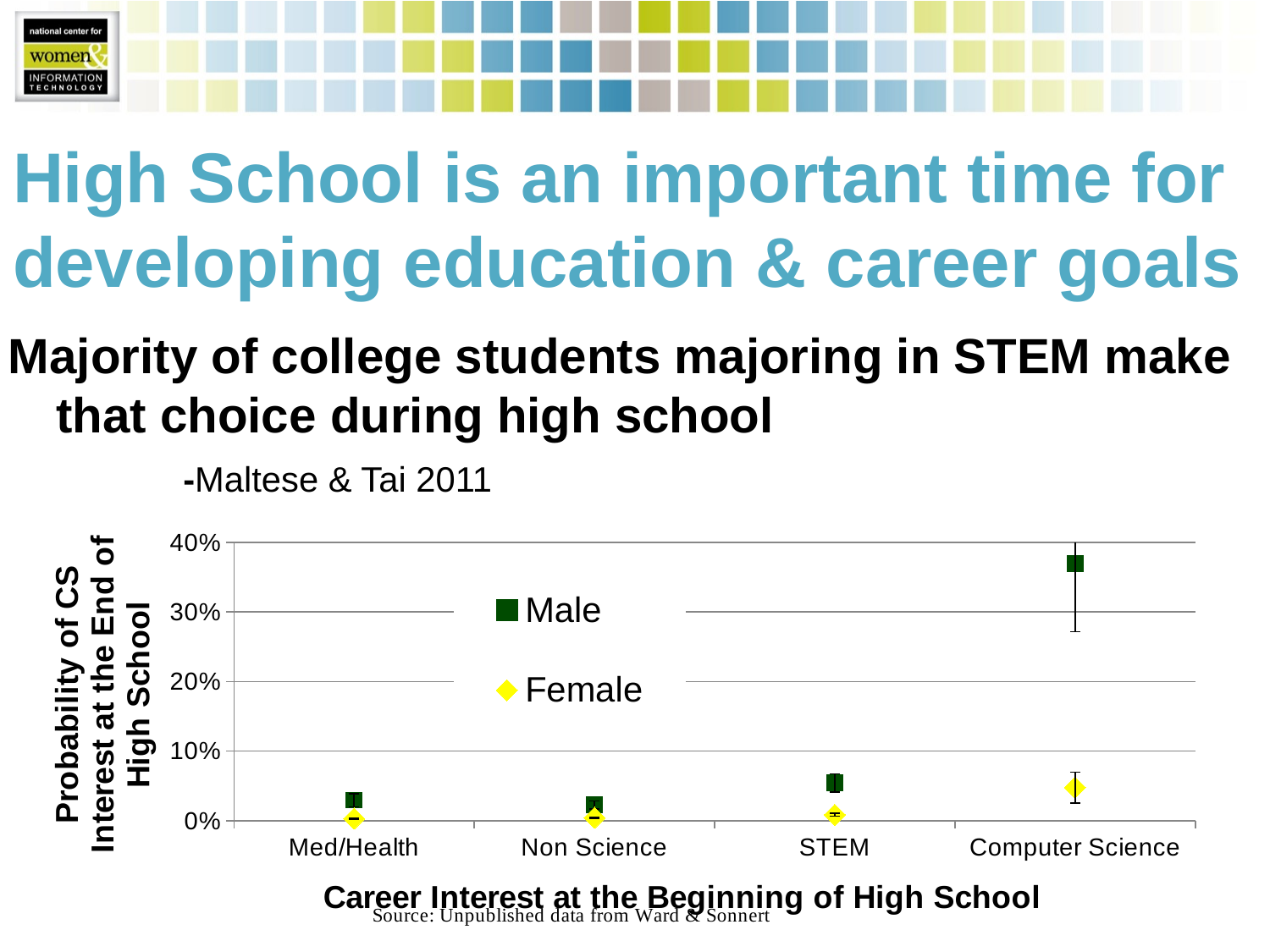
What marker shape and colour represents the Female series in the legend? Yellow diamond How many categories are shown on the x axis of the chart? 4 Is the Female value for Computer Science greater or less than 10%? less Is the Male value for STEM greater or less than 10%? less For the Male series, which is larger: the value for Computer Science or the value for STEM? Computer Science Which category has the highest Female value? Computer Science What is the title of the chart's x axis? Career Interest at the Beginning of High School Is the Male value for Computer Science greater or less than 40%? less How many series does the chart's legend list? 2 For Computer Science, which is larger: the Male value or the Female value? Male Which category has the highest Male value? Computer Science